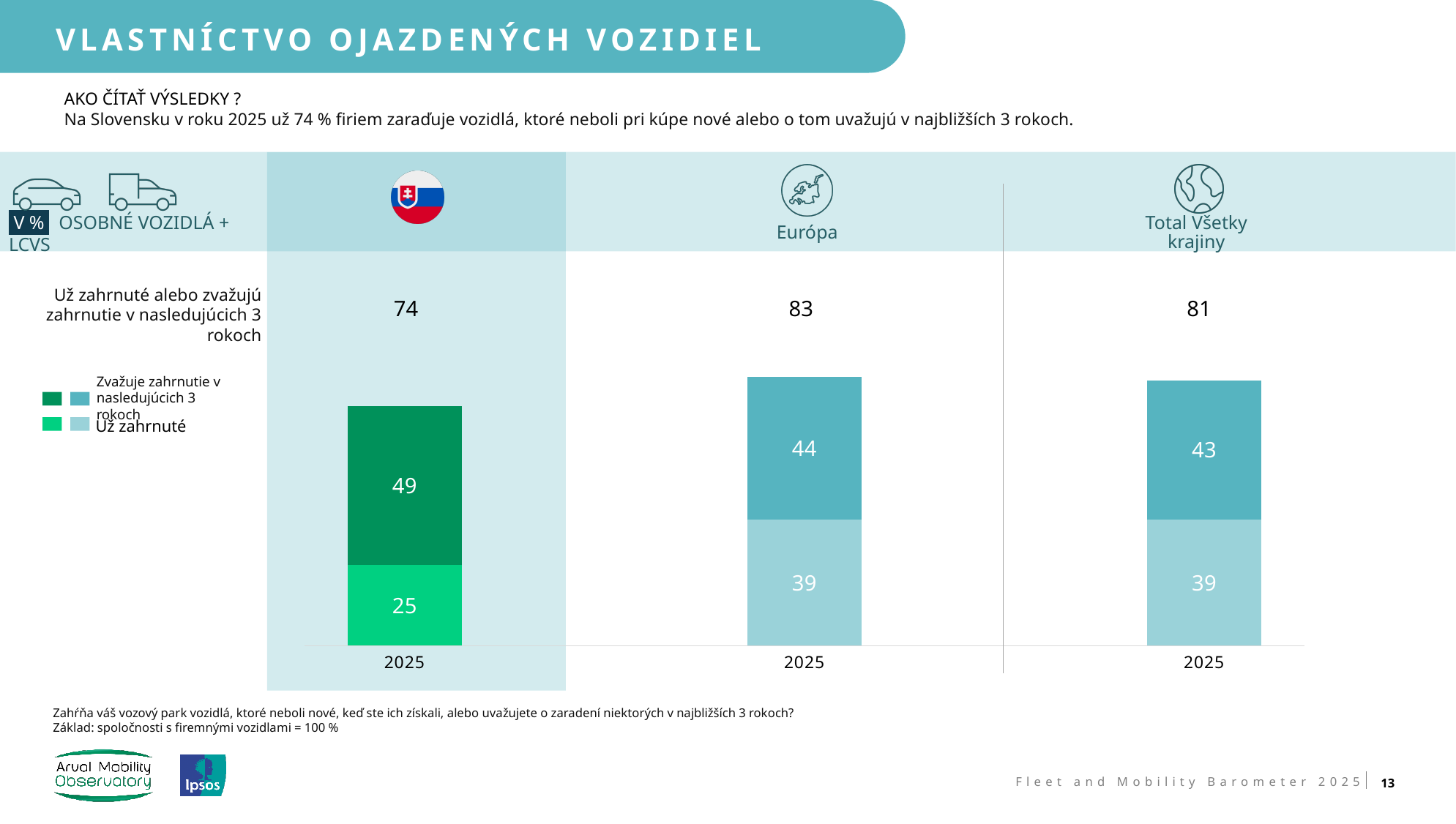
In the Európa chart, what is the value of the 'Už zahrnuté' segment for 2025? 39 In the Slovakia chart (with the flag), what is the value of the 'Už zahrnuté' segment for 2025? 25 In the Total Všetky krajiny chart, what is the total shown above the 2025 stacked bar? 81 What kind of chart is used in the Európa chart? Stacked bar chart In the Európa chart, what is the difference between the 'Zvažuje zahrnutie v nasledujúcich 3 rokoch' segment and the 'Už zahrnuté' segment for 2025? 5 Which of the three charts has the highest total for 2025? Európa In the Total Všetky krajiny chart, what is the value of the 'Zvažuje zahrnutie v nasledujúcich 3 rokoch' segment for 2025? 43 How many series does the legend list for the charts? 2 In the Slovakia chart (with the flag), what is the total of the two segments of the 2025 stacked bar? 74 Which is larger in the Slovakia chart (with the flag): the 'Už zahrnuté' segment or the 'Zvažuje zahrnutie v nasledujúcich 3 rokoch' segment? Zvažuje zahrnutie v nasledujúcich 3 rokoch In the Európa chart, what is the value of the 'Zvažuje zahrnutie v nasledujúcich 3 rokoch' segment for 2025? 44 In the Slovakia chart (with the flag), what is the value of the 'Zvažuje zahrnutie v nasledujúcich 3 rokoch' segment for 2025? 49